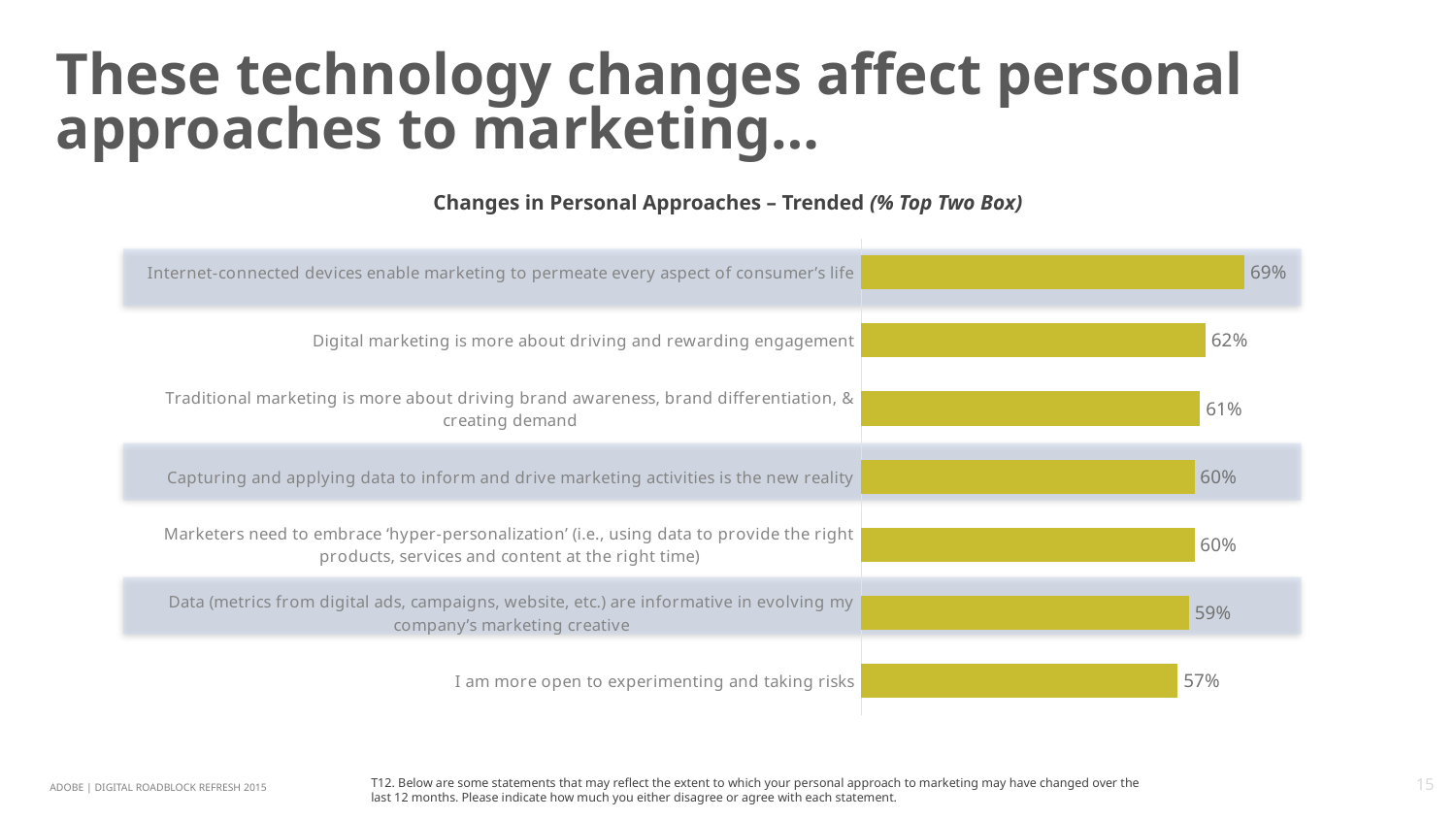
What type of chart is shown on the slide? Bar chart What is the title of the chart? Changes in Personal Approaches – Trended (% Top Two Box) Which statement has the highest percentage? Internet-connected devices enable marketing to permeate every aspect of consumer's life What is the difference between 'Digital marketing is more about driving and rewarding engagement' and 'Traditional marketing is more about driving brand awareness, brand differentiation, & creating demand'? 1% What is the value for 'I am more open to experimenting and taking risks'? 57% What percentage of respondents agree that internet-connected devices enable marketing to permeate every aspect of consumer's life? 69% What is the value for 'Data (metrics from digital ads, campaigns, website, etc.) are informative in evolving my company's marketing creative'? 59% Which statement has the lowest percentage? I am more open to experimenting and taking risks What is the value for 'Digital marketing is more about driving and rewarding engagement'? 62% Which is larger: the value for 'Capturing and applying data to inform and drive marketing activities is the new reality' or the value for 'I am more open to experimenting and taking risks'? Capturing and applying data to inform and drive marketing activities is the new reality What is the difference between the highest and lowest values shown? 12% How many statements are shown in the chart? 7